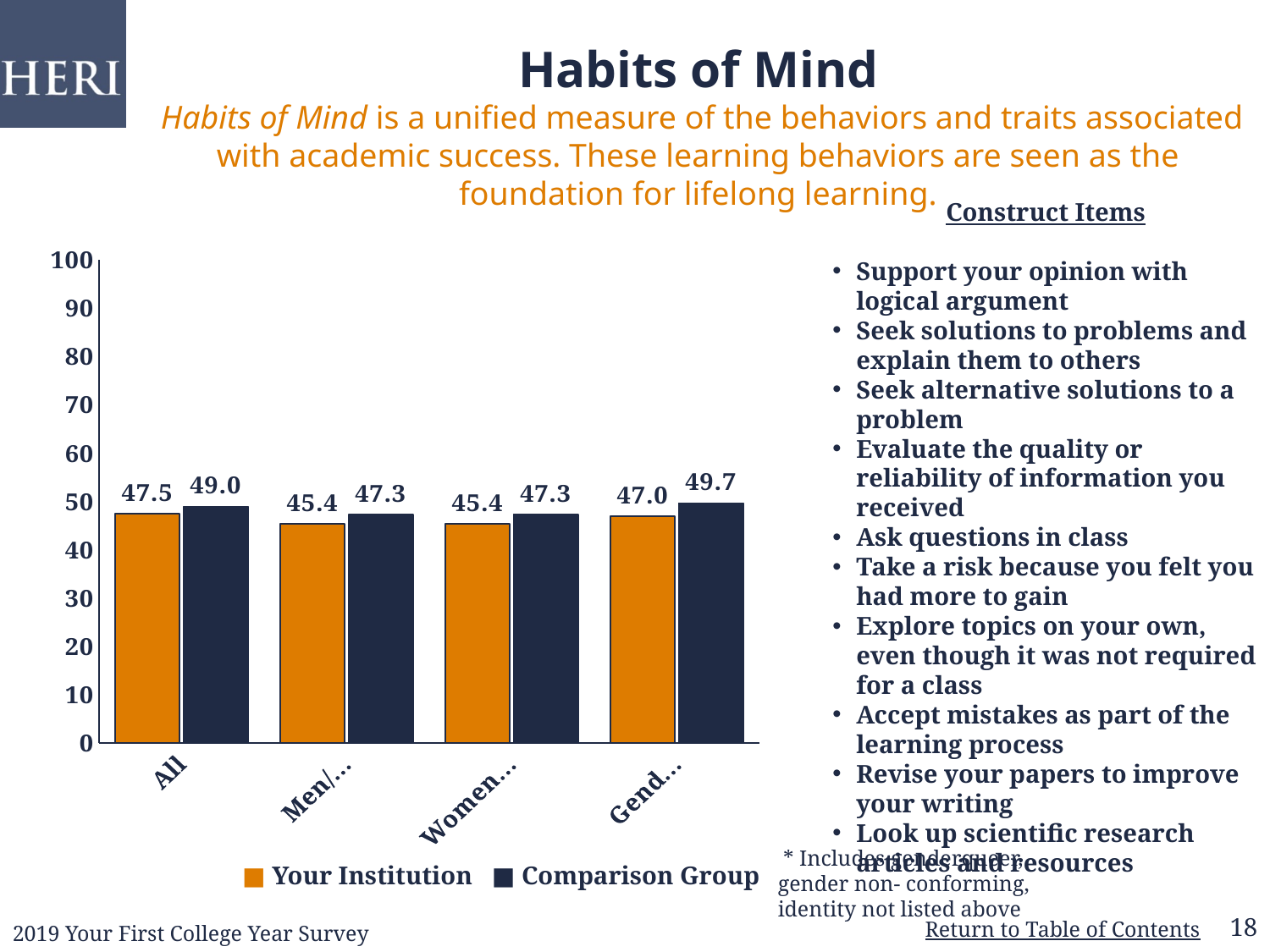
What is the value for the Comparison Group in the All category? 49.0 What is the difference between the Comparison Group and Your Institution values in the All category? 1.5 In the All category, which is larger: Your Institution or Comparison Group? Comparison Group What is the value for Your Institution in the All category? 47.5 What is the Your Institution value for the second category (labeled 'Men/...')? 45.4 Which category has the highest Comparison Group value? Gend... (the fourth category) What is the Comparison Group value for the fourth category (labeled 'Gend...')? 49.7 How many series does the legend list? 2 What is the difference between the Comparison Group and Your Institution values in the fourth category (labeled 'Gend...')? 2.7 Is the Your Institution value for the All category greater or less than 50? less What type of chart is shown on the slide? bar chart How many categories are shown on the x axis? 4